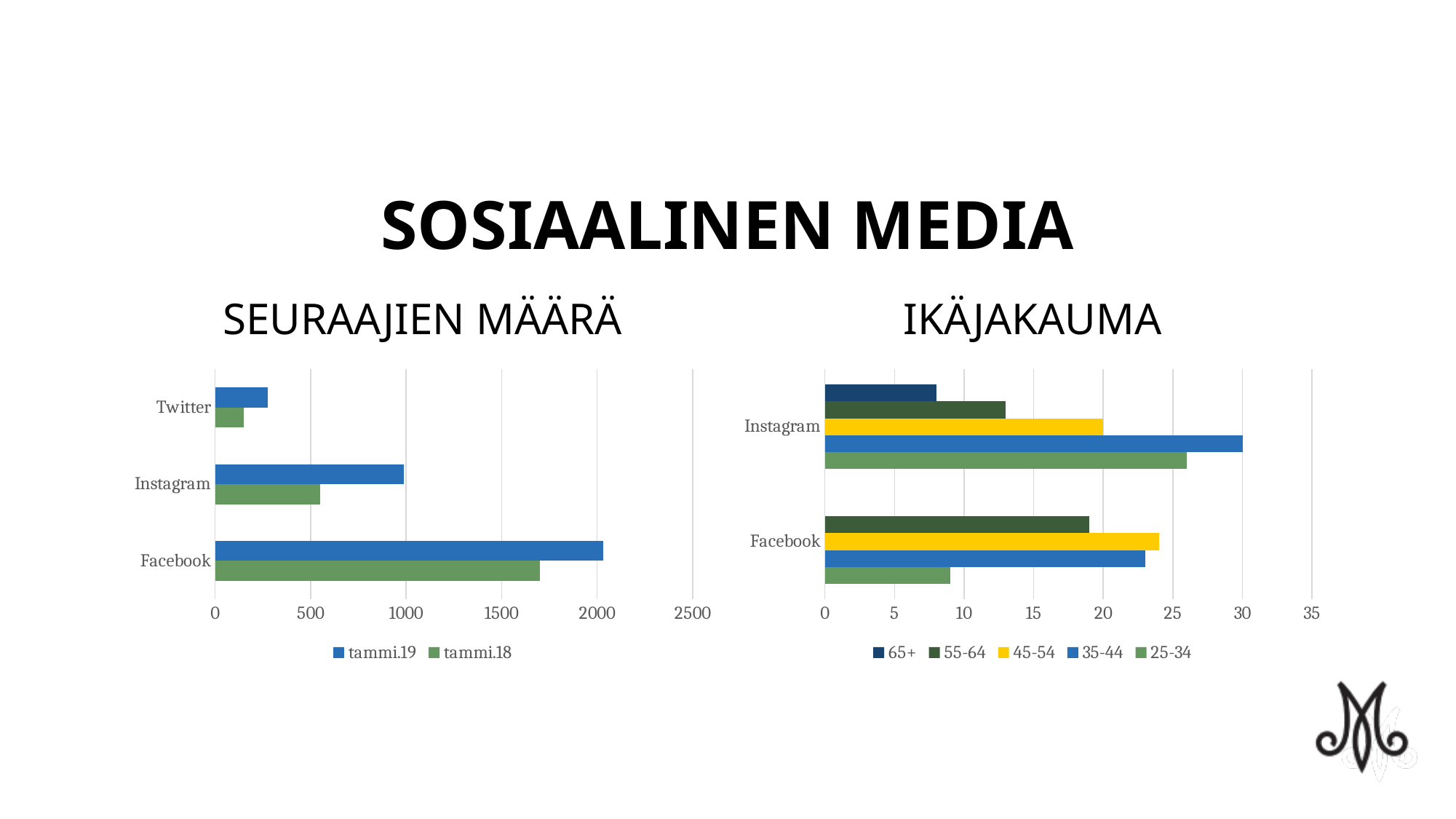
What kind of chart is the SEURAAJIEN MÄÄRÄ chart on the left? bar chart How many series does the legend of the IKÄJAKAUMA chart list? 5 How many series does the legend of the SEURAAJIEN MÄÄRÄ chart list? 2 In the SEURAAJIEN MÄÄRÄ chart, is the tammi.18 value for Facebook greater or less than 1500? greater In the IKÄJAKAUMA chart, what colour represents the 45-54 age group? yellow How many categories are shown on the SEURAAJIEN MÄÄRÄ chart? 3 In the SEURAAJIEN MÄÄRÄ chart, which category has the highest tammi.19 value? Facebook In the IKÄJAKAUMA chart, is the 35-44 value for Instagram greater or less than 25? greater In the IKÄJAKAUMA chart, which is larger for Facebook: 45-54 or 55-64? 45-54 In the SEURAAJIEN MÄÄRÄ chart, which is larger for Instagram: tammi.19 or tammi.18? tammi.19 In the SEURAAJIEN MÄÄRÄ chart, is the tammi.19 value for Twitter greater or less than 500? less In the IKÄJAKAUMA chart, which age group has the highest value for Instagram? 35-44